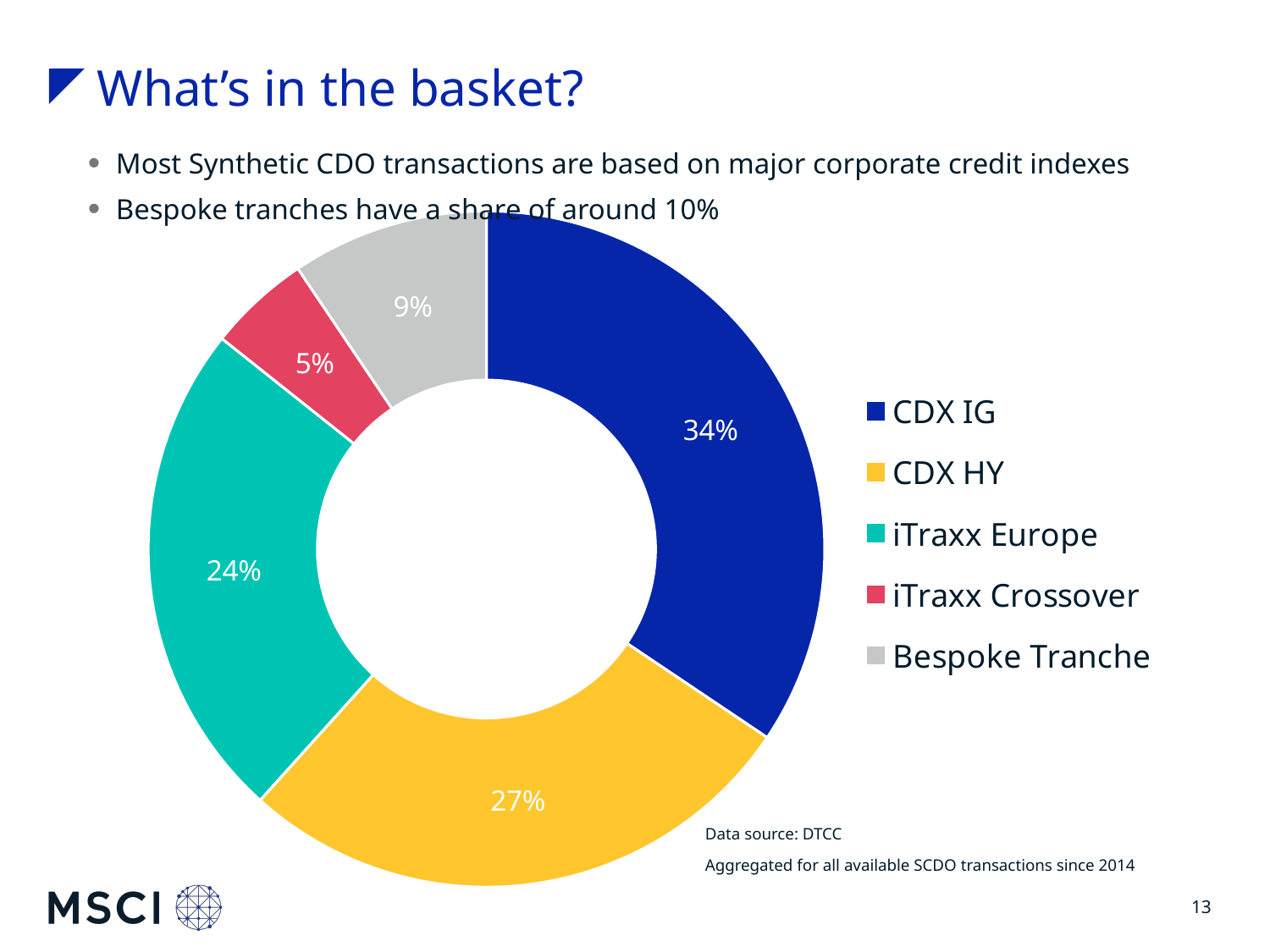
What kind of chart is shown on the slide? Pie chart (doughnut) What is the difference in percentage points between the CDX IG share and the CDX HY share? 7 Which has a larger share, iTraxx Europe or Bespoke Tranche? iTraxx Europe What share of the basket is iTraxx Crossover? 5% What share of the basket is iTraxx Europe? 24% What share of the basket is CDX HY? 27% What share of the basket is Bespoke Tranche? 9% Which category has the largest share of the basket? CDX IG What share of the basket is CDX IG? 34% How many categories does the chart show? 5 Which category has the smallest share of the basket? iTraxx Crossover What colour is the CDX HY slice? Yellow